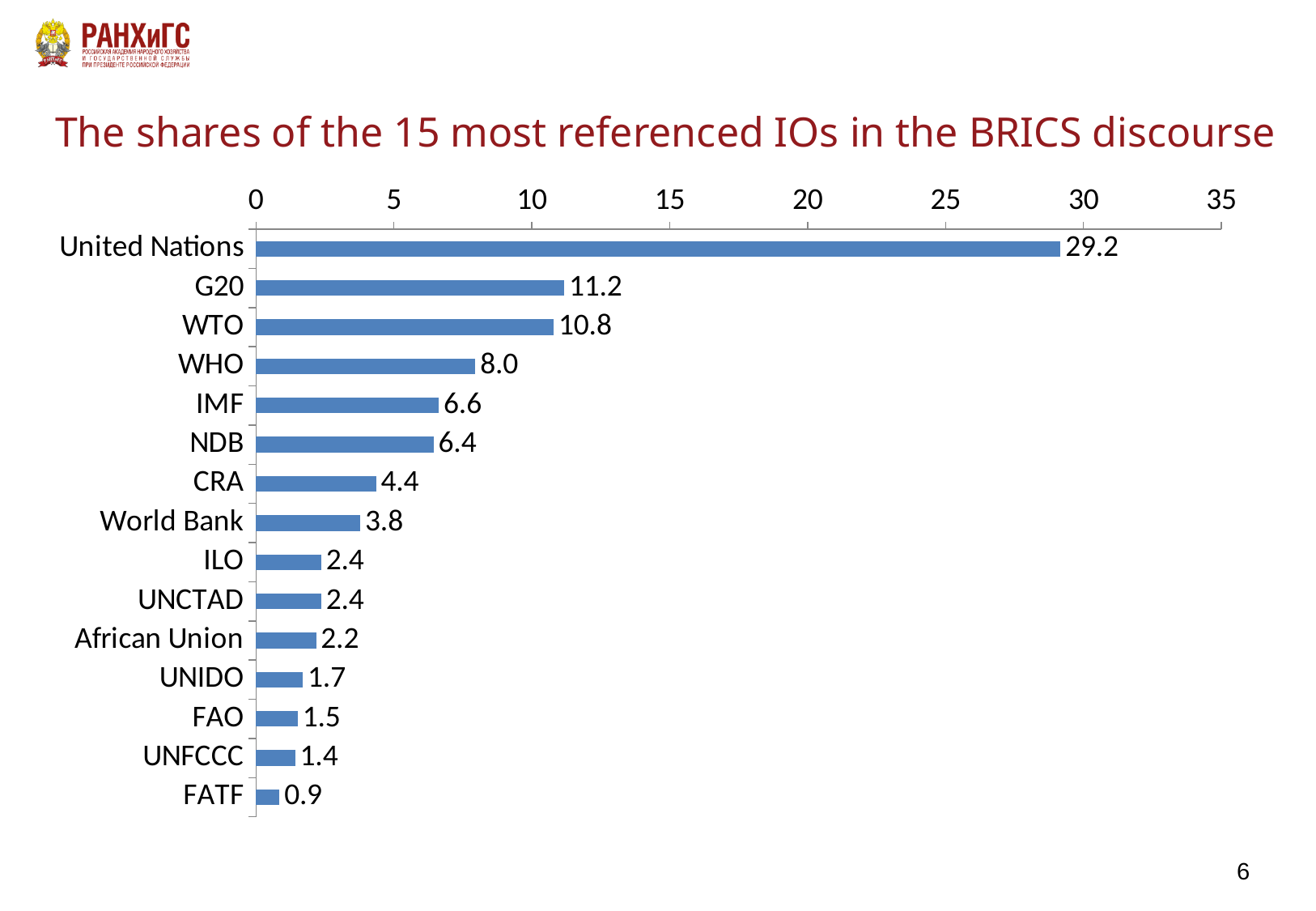
What is the difference between the values for G20 and WTO? 0.4 Which organisation has the highest share? United Nations What is the difference between the values for the United Nations and the World Bank? 25.4 What kind of chart is shown on the slide? bar chart Is the value for WTO greater or less than 10? greater What is the value for the United Nations? 29.2 What is the title of the chart? The shares of the 15 most referenced IOs in the BRICS discourse Which organisation has the lowest share? FATF What is the value for the African Union? 2.2 Which is larger, the value for IMF or the value for CRA? IMF What is the value for WHO? 8.0 How many organisations are shown in the chart? 15